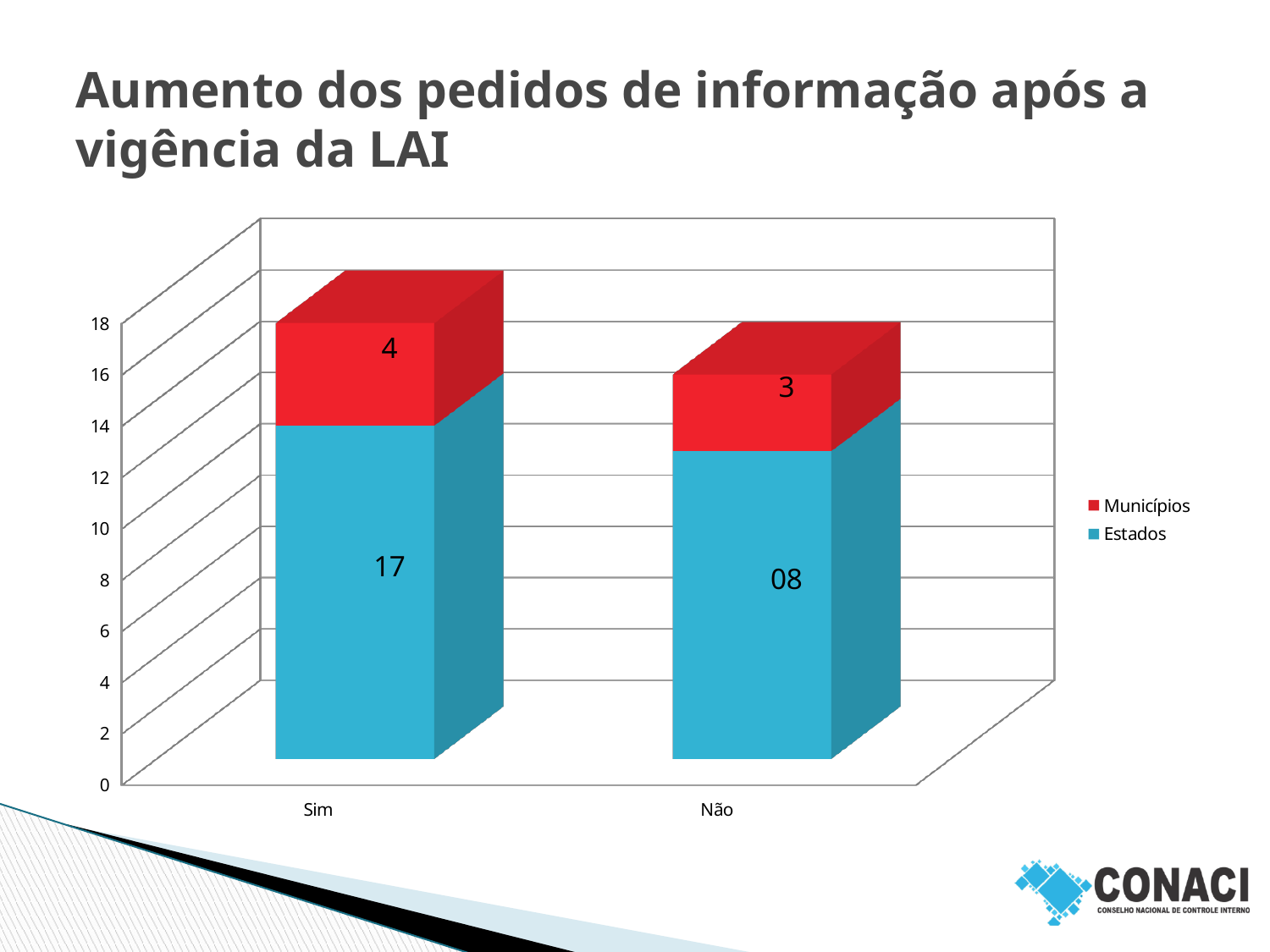
Which category has the lowest value for Municípios? Não What is the value for Municípios in the Não category? 3 What is the total of the stacked bar for Não? 11 How many categories are shown on the x axis? 2 What kind of chart is shown on the slide? Stacked bar chart How many series does the legend list? 2 Which category has the higher value for Estados, Sim or Não? Sim What is the value for Estados in the Sim category? 17 What is the total of the stacked bar for Sim? 21 What is the value for Estados in the Não category? 08 What is the value for Municípios in the Sim category? 4 What is the difference between the Estados values for Sim and Não? 9